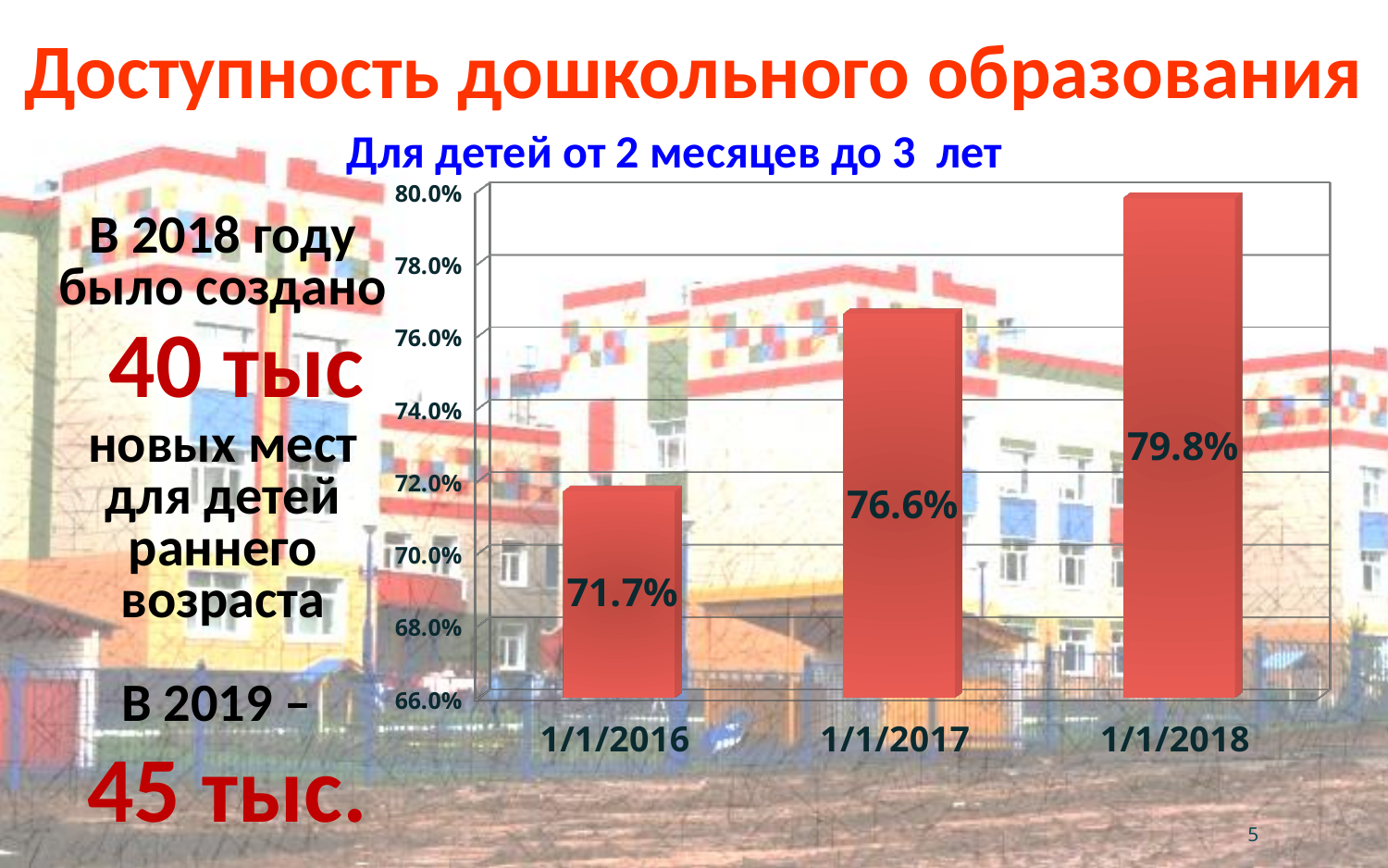
Which is larger, the value for 1/1/2017 or the value for 1/1/2016? 1/1/2017 What is the difference between the values for 1/1/2017 and 1/1/2016? 4.9% Is the value for 1/1/2017 greater or less than 74.0%? greater What kind of chart is shown on the slide? bar chart Which date has the lowest value? 1/1/2016 How many bars are shown in the chart? 3 Which date has the highest value? 1/1/2018 What is the difference between the values for 1/1/2018 and 1/1/2016? 8.1% What is the value for 1/1/2017? 76.6% What is the value for 1/1/2018? 79.8% Do the values rise or fall from 1/1/2016 to 1/1/2018? rise What is the value for 1/1/2016? 71.7%